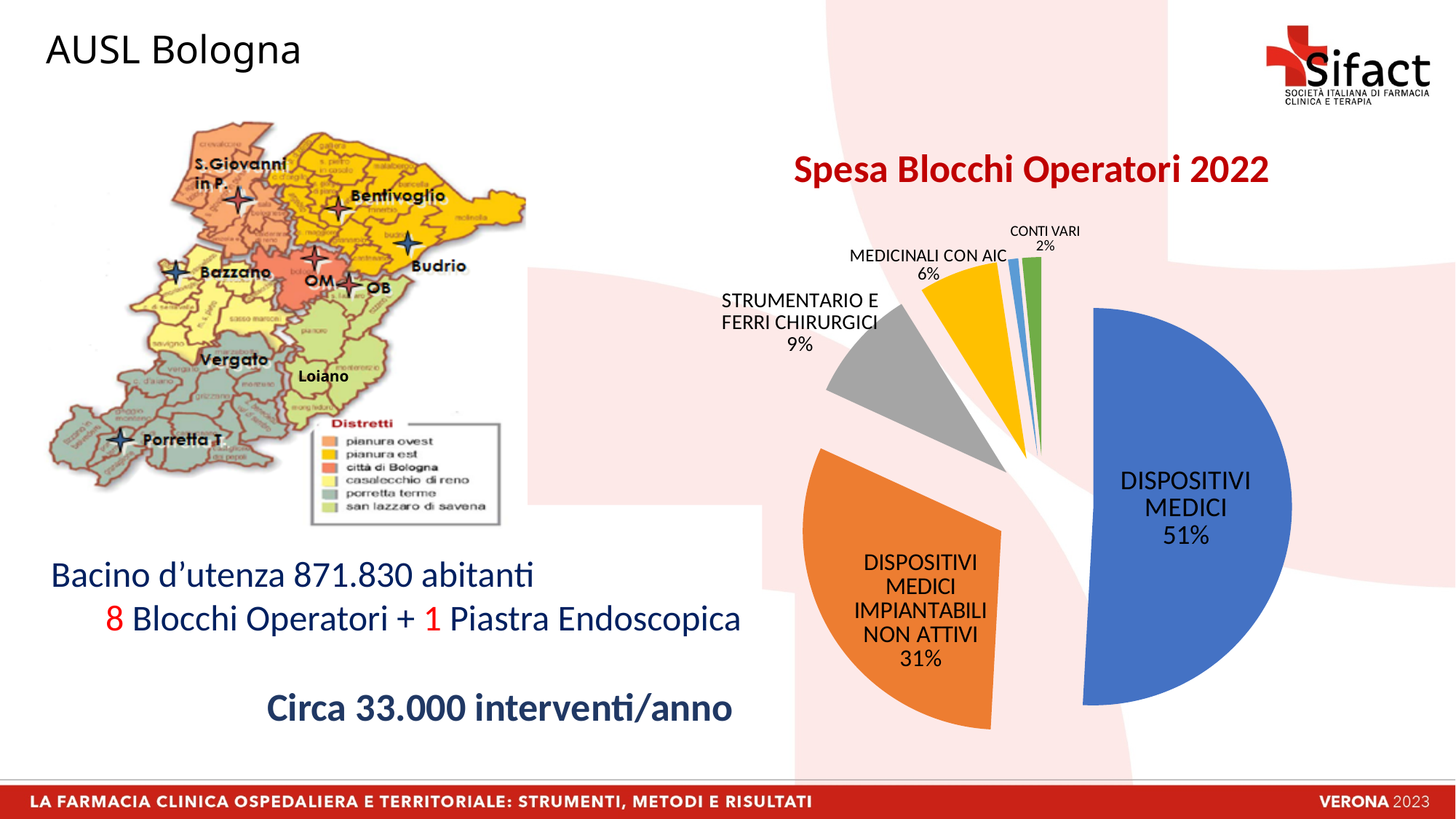
What percentage is shown for STRUMENTARIO E FERRI CHIRURGICI? 9% What percentage is shown for CONTI VARI? 2% What percentage is shown for DISPOSITIVI MEDICI IMPIANTABILI NON ATTIVI? 31% Which is larger, the share for STRUMENTARIO E FERRI CHIRURGICI or the share for MEDICINALI CON AIC? STRUMENTARIO E FERRI CHIRURGICI Which category has the largest share of the pie? DISPOSITIVI MEDICI Which labelled category has the smallest share of the pie? CONTI VARI What is the title of the chart? Spesa Blocchi Operatori 2022 What colour is the DISPOSITIVI MEDICI slice? Blue What is the difference in percentage points between DISPOSITIVI MEDICI and DISPOSITIVI MEDICI IMPIANTABILI NON ATTIVI? 20 percentage points What percentage is shown for MEDICINALI CON AIC? 6% What kind of chart is shown on the slide? Pie chart What share of the pie does DISPOSITIVI MEDICI represent? 51%